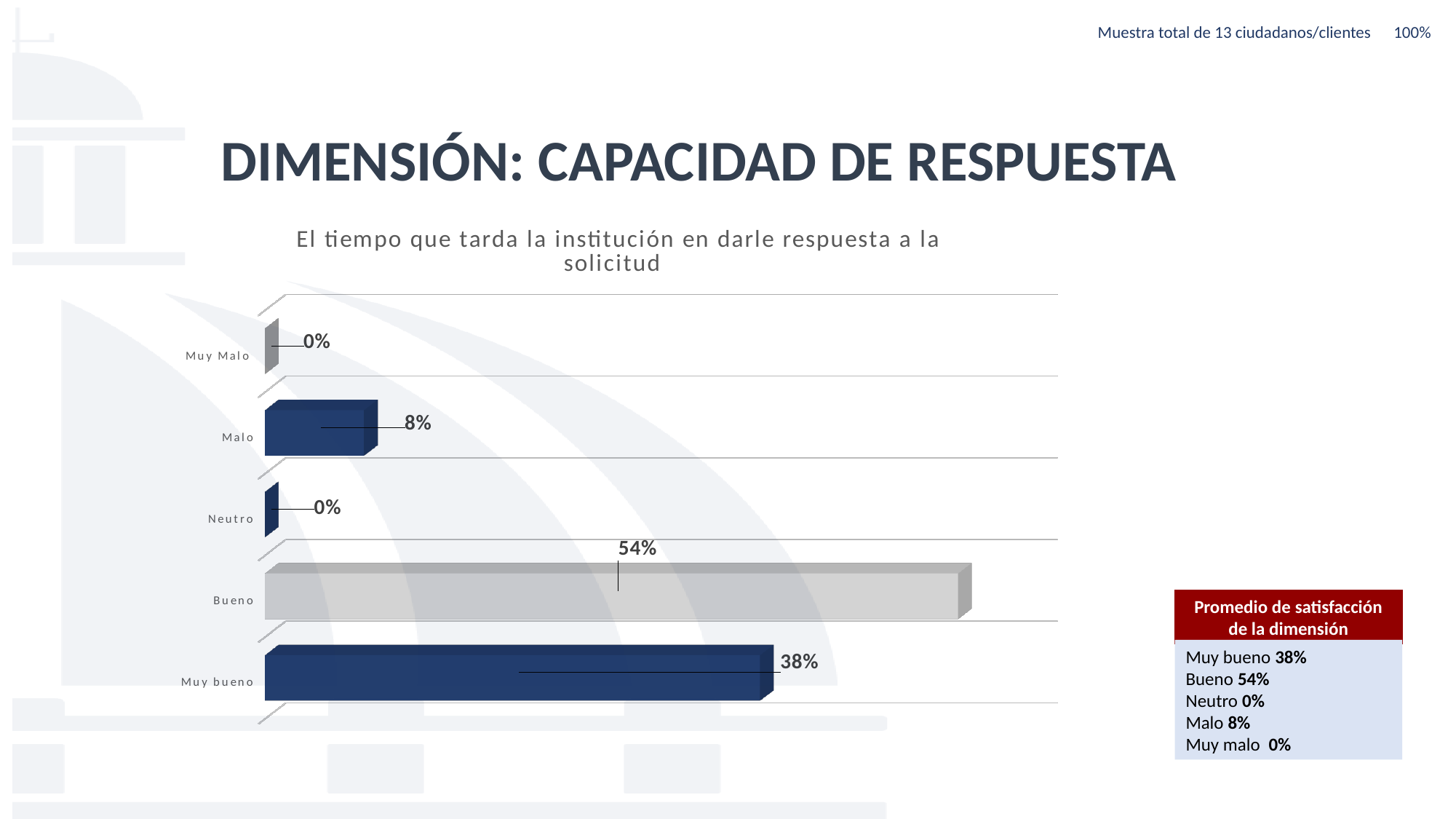
Which is larger, the value for Malo or the value for Muy bueno? Muy bueno What is the total of the values for Bueno and Muy bueno combined? 92% What is the title of the chart? El tiempo que tarda la institución en darle respuesta a la solicitud How many categories are shown on the chart? 5 Which category has the highest value? Bueno What is the value for Neutro? 0% What is the value for Muy bueno? 38% What kind of chart is shown on the slide? Bar chart What is the difference between the values for Muy bueno and Malo? 30% What is the value for Bueno? 54% What is the difference between the values for Bueno and Muy bueno? 16% What is the value for Malo? 8%